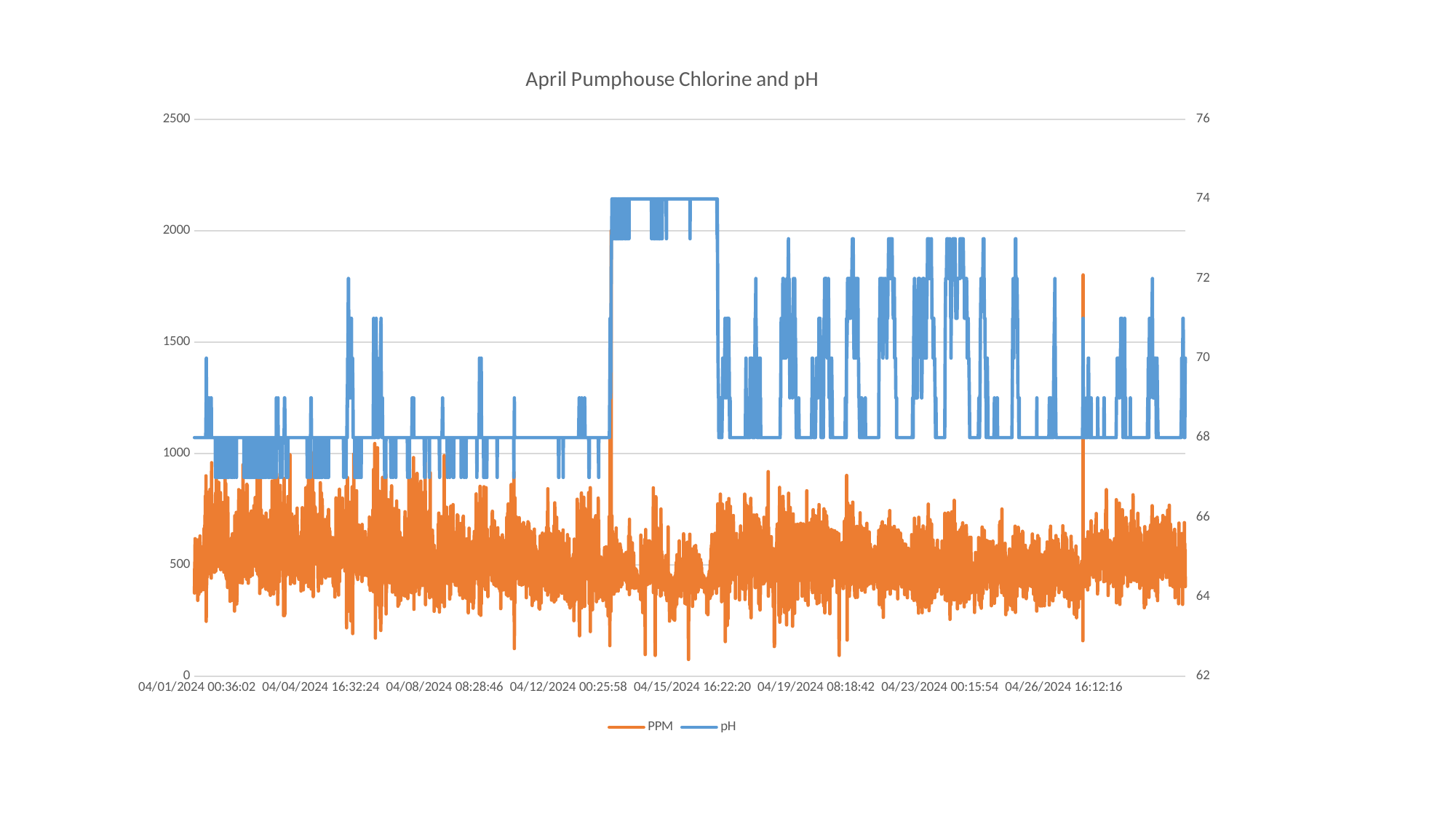
Is the pH value at 04/15/2024 16:22:20 greater or less than 72? greater Is the PPM value at 04/26/2024 16:12:16 greater or less than 1500? less Is the pH value at 04/08/2024 08:28:46 greater or less than 72? less How many series does the legend list? 2 What is the title of the chart? April Pumphouse Chlorine and pH What kind of chart is shown on the slide? Line chart Which colour is used for the PPM series? Orange